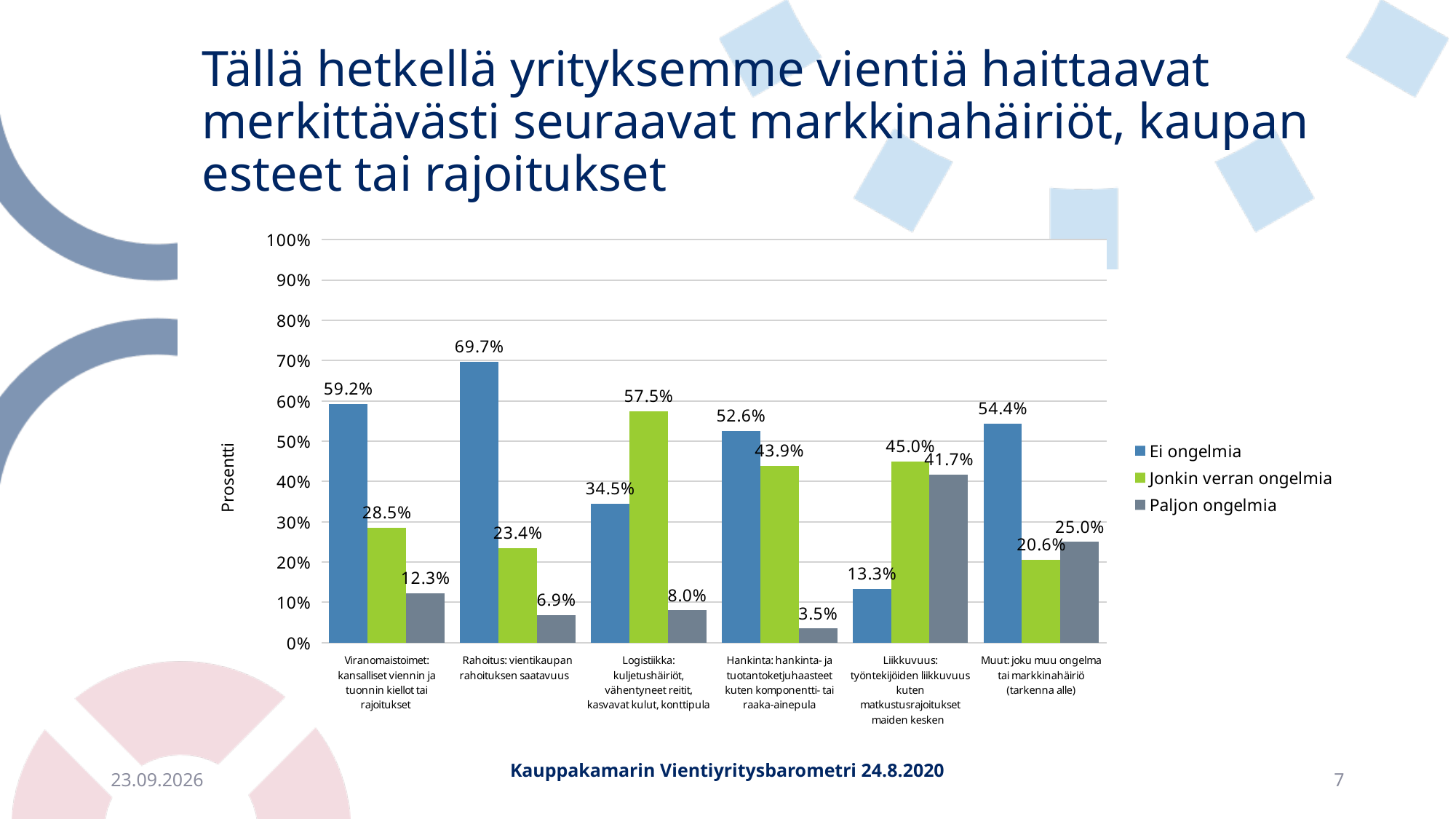
How many series does the legend list? 3 What is the value of "Paljon ongelmia" for the Liikkuvuus category? 41.7% What is the difference between the "Ei ongelmia" and "Jonkin verran ongelmia" values for the Viranomaistoimet category? 30.7% What kind of chart is shown on the slide? Bar chart What is the value of "Ei ongelmia" for the Rahoitus category? 69.7% How many categories are shown on the x axis? 6 Which is larger for the Liikkuvuus category: "Jonkin verran ongelmia" or "Paljon ongelmia"? Jonkin verran ongelmia What is the label of the y axis? Prosentti What is the value of "Jonkin verran ongelmia" for the Logistiikka category? 57.5% Which category has the highest "Ei ongelmia" value? Rahoitus: vientikaupan rahoituksen saatavuus Is the "Ei ongelmia" value for the Muut category greater or less than 50%? greater Which category has the lowest "Paljon ongelmia" value? Hankinta: hankinta- ja tuotantoketjuhaasteet kuten komponentti- tai raaka-ainepula